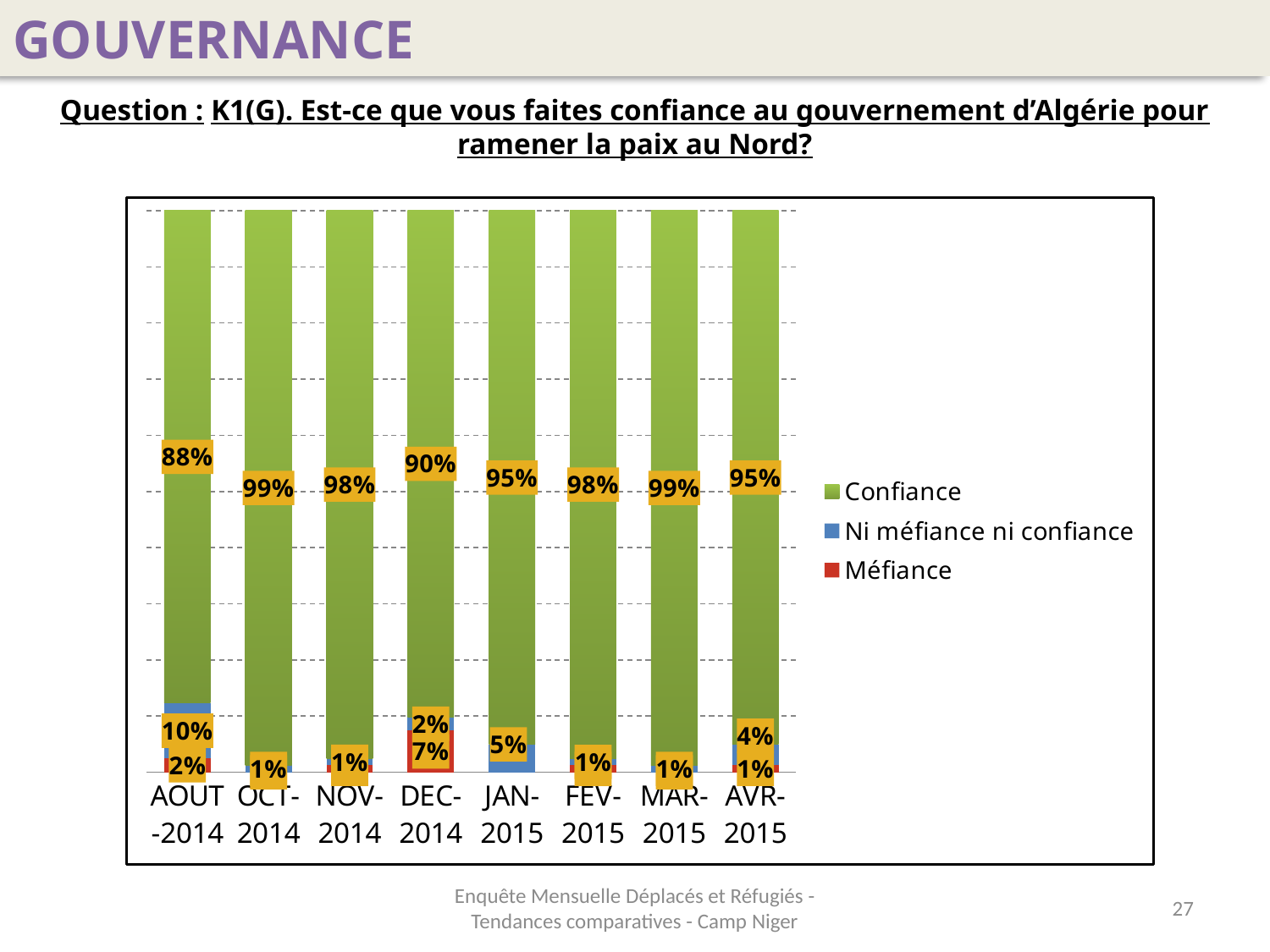
What is the Confiance value for AOUT-2014? 88% Which series is shown in green in the legend? Confiance What is the Confiance value for DEC-2014? 90% What is the difference between the Confiance values for OCT-2014 and AOUT-2014? 11% How many months are shown on the x axis? 8 What is the Méfiance value for DEC-2014? 7% Which month has the lowest Confiance value? AOUT-2014 What kind of chart is shown on the slide? Stacked bar chart What is the Ni méfiance ni confiance value for AOUT-2014? 10% Which is larger, the Confiance value for JAN-2015 or for FEV-2015? FEV-2015 How many series does the legend list? 3 What is the Ni méfiance ni confiance value for JAN-2015? 5%